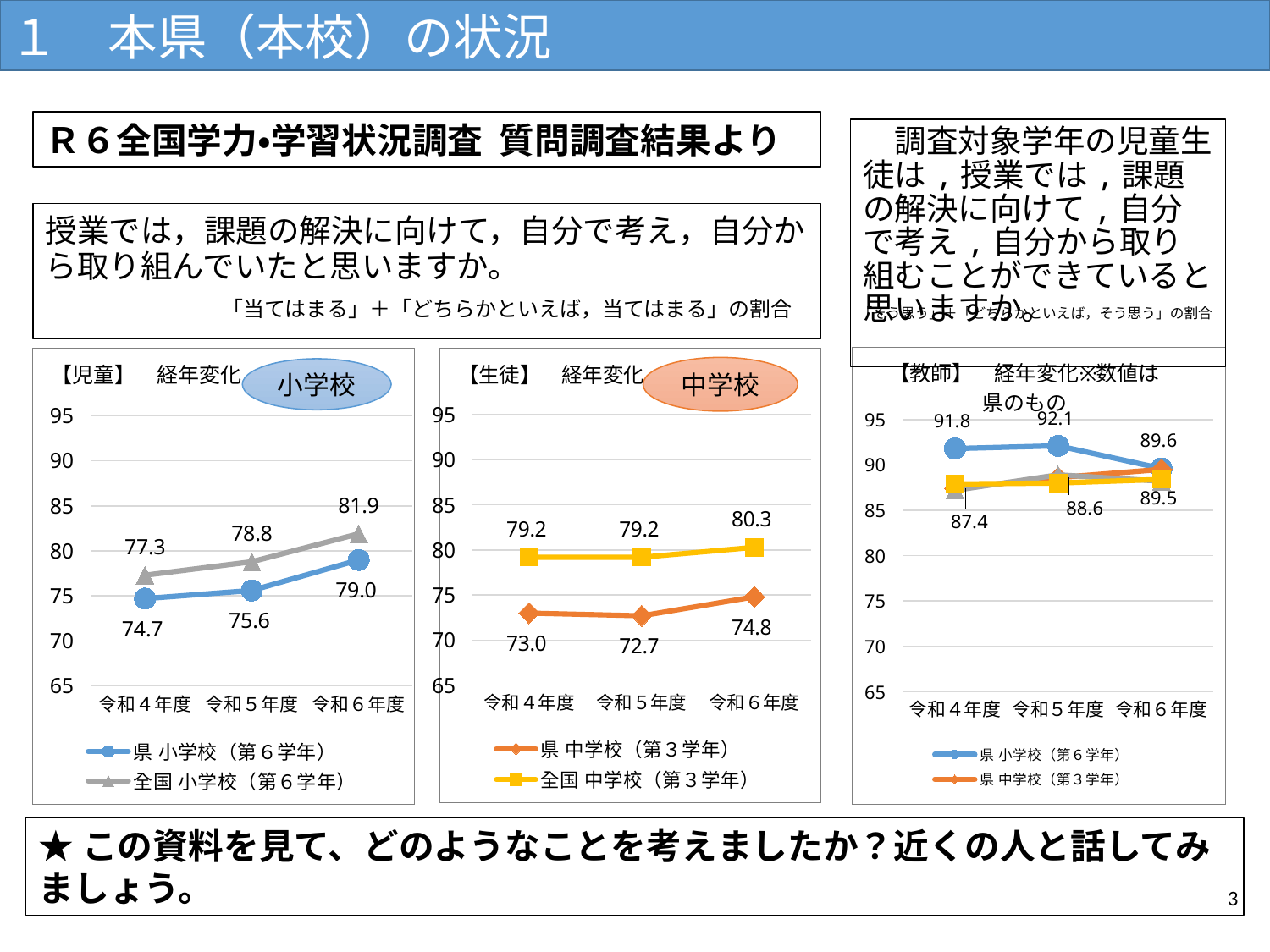
In the right chart (【教師】), what is the value for 県 中学校（第３学年） in 令和４年度? 87.4 What kind of chart is the left chart (【児童】 小学校)? line chart In the left chart (【児童】 小学校), what is the value for 県 小学校（第６学年） in 令和６年度? 79.0 In the left chart (【児童】 小学校), what is the difference between 全国 小学校（第６学年） and 県 小学校（第６学年） in 令和５年度? 3.2 In the left chart (【児童】 小学校), does the value for 県 小学校（第６学年） rise or fall from 令和４年度 to 令和６年度? rise In the middle chart (【生徒】 中学校), in which year is the value for 県 中学校（第３学年） lowest? 令和５年度 In the middle chart (【生徒】 中学校), what is the value for 県 中学校（第３学年） in 令和５年度? 72.7 In the middle chart (【生徒】 中学校), which is larger in 令和６年度: 県 中学校（第３学年） or 全国 中学校（第３学年）? 全国 中学校（第３学年） In the middle chart (【生徒】 中学校), how many series does the legend list? 2 In the left chart (【児童】 小学校), what is the value for 全国 小学校（第６学年） in 令和４年度? 77.3 In the right chart (【教師】), in which year is the value for 県 小学校（第６学年） highest? 令和５年度 In the right chart (【教師】), what is the value for 県 小学校（第６学年） in 令和５年度? 92.1